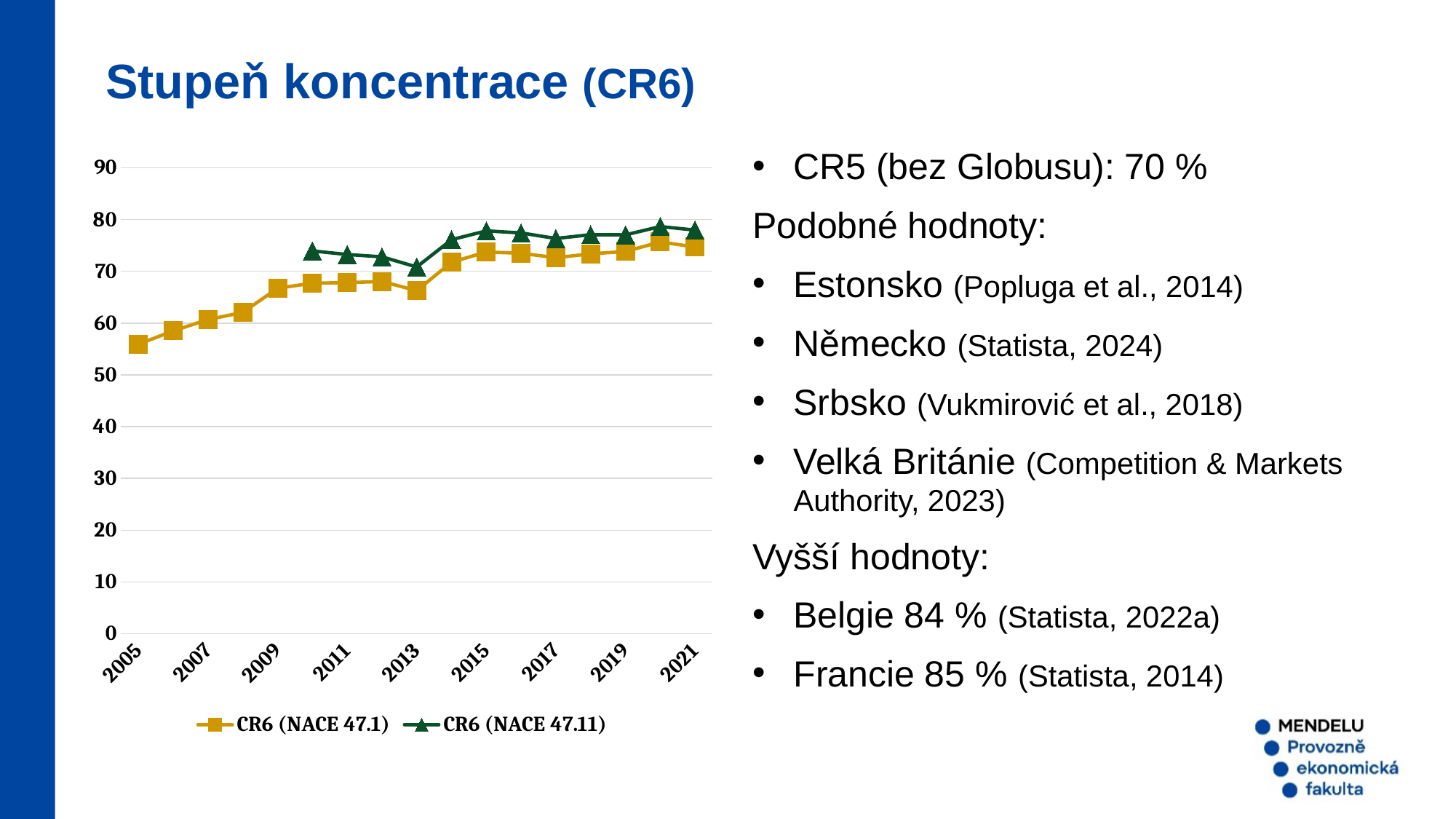
Is the value for CR6 (NACE 47.1) in 2005 greater or less than 50? greater Is the value for CR6 (NACE 47.11) in 2015 greater or less than 80? less Is the value for CR6 (NACE 47.11) in 2021 greater or less than 70? greater What kind of chart is shown on the slide? line chart Does the CR6 (NACE 47.1) series generally rise or fall from 2005 to 2021? rise How many series does the chart legend list? 2 In 2021, which series has the higher value, CR6 (NACE 47.1) or CR6 (NACE 47.11)? CR6 (NACE 47.11) In which year does the CR6 (NACE 47.1) series have its lowest value? 2005 What are the two series named in the chart legend? CR6 (NACE 47.1) and CR6 (NACE 47.11) Which series in the chart starts later on the x axis, CR6 (NACE 47.1) or CR6 (NACE 47.11)? CR6 (NACE 47.11)